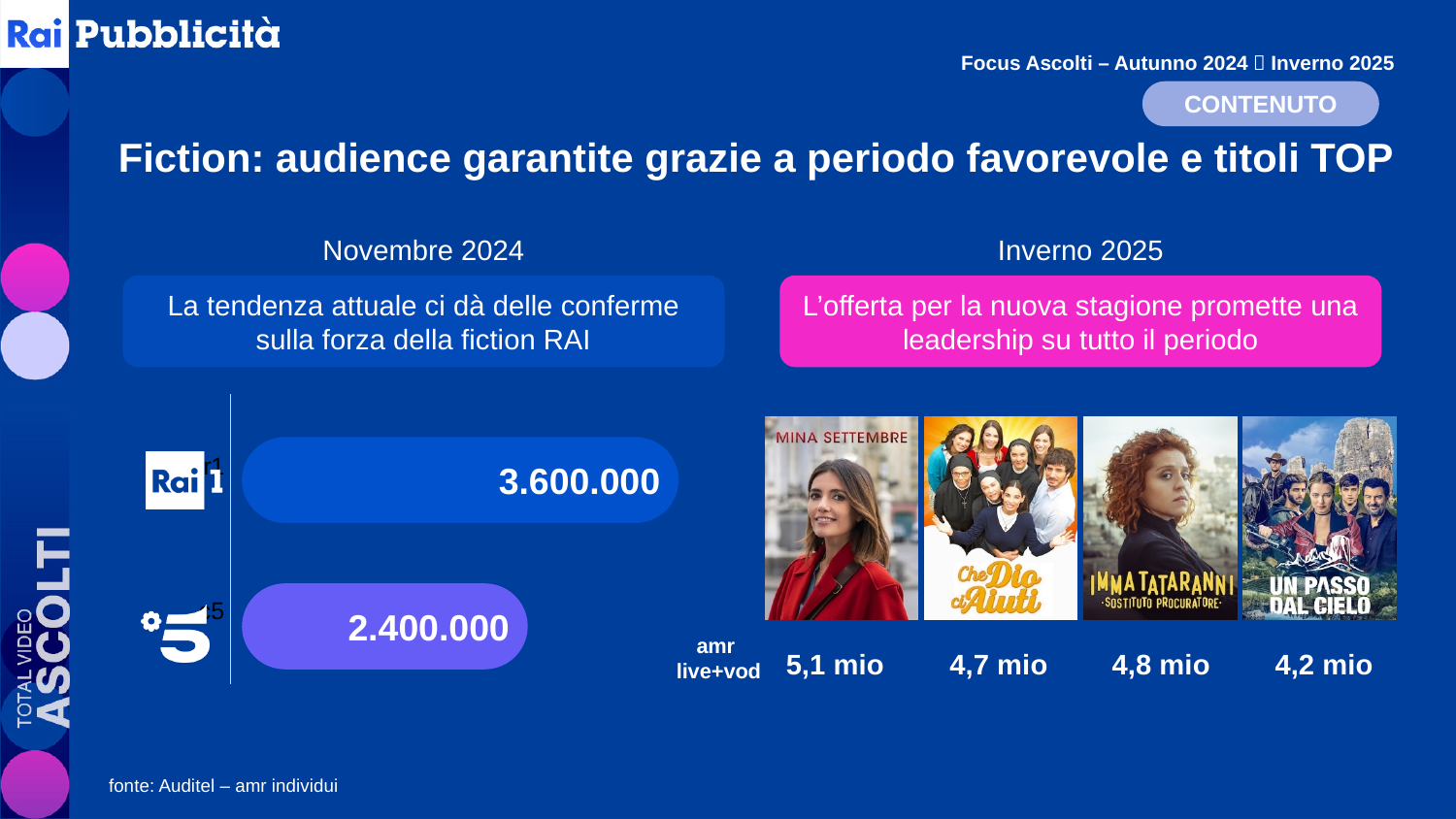
In the bar chart under 'Novembre 2024', is the value for Rai 1 larger or smaller than the value for Canale 5? larger In the bar chart under 'Novembre 2024', which channel has the lowest value? Canale 5 Are the bars in the chart under 'Novembre 2024' horizontal or vertical? horizontal What is the source cited at the bottom of the slide for the chart data? Auditel – amr individui In the bar chart under 'Novembre 2024', what is the value for Rai 1? 3.600.000 What kind of chart is shown on the left of the slide under 'Novembre 2024'? bar chart In the bar chart under 'Novembre 2024', which channel has the highest value? Rai 1 In the bar chart under 'Novembre 2024', what is the value for Canale 5? 2.400.000 In the bar chart under 'Novembre 2024', what is the difference between the Rai 1 value and the Canale 5 value? 1.200.000 How many bars are shown in the bar chart under 'Novembre 2024'? 2